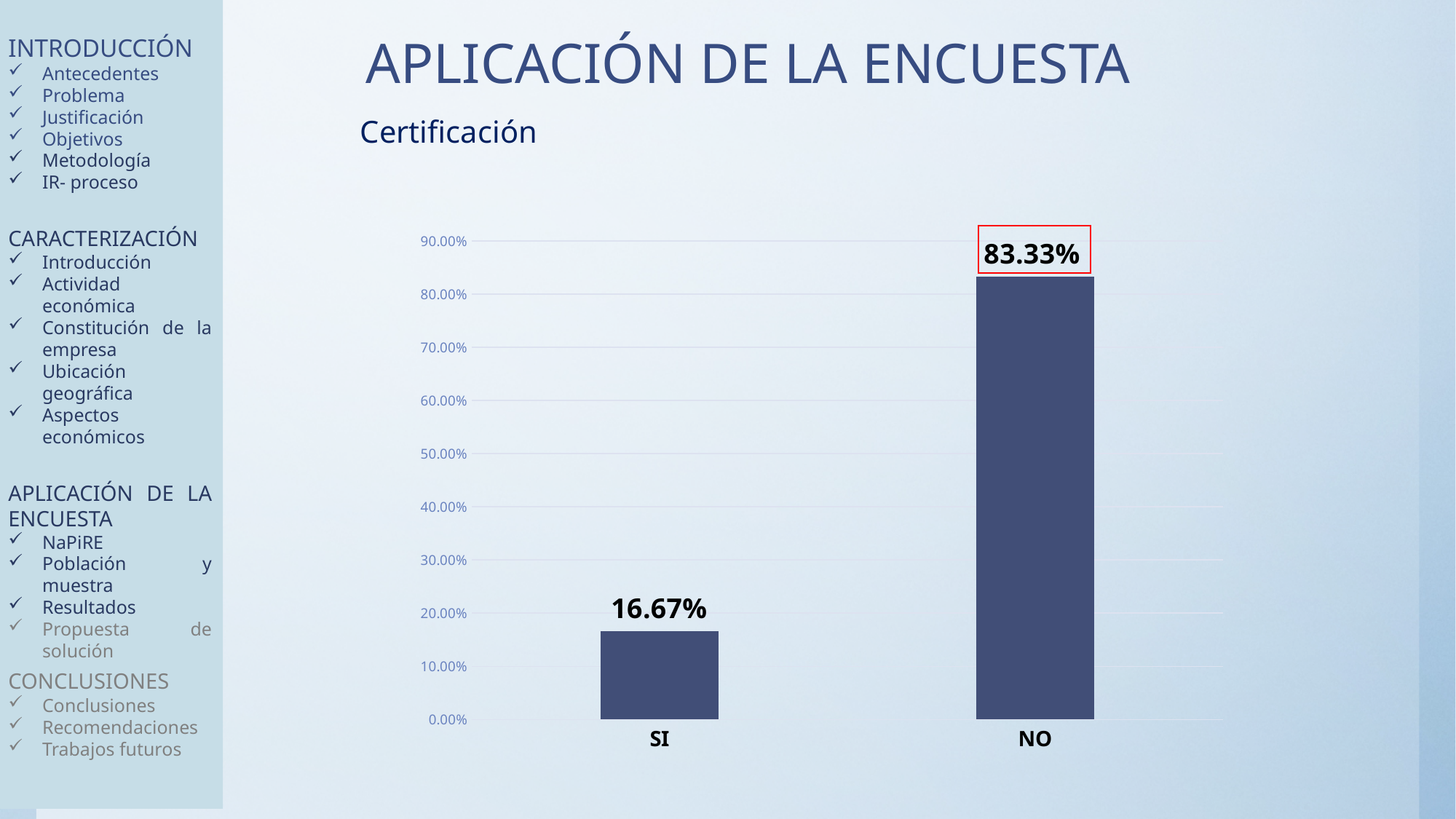
Which category has the highest value? NO What is the difference between the values for NO and SI? 66.66% What is the value for SI? 16.67% What is the value for NO? 83.33% How many categories are shown on the x axis? 2 Which is larger, the value for SI or the value for NO? NO What is the title shown above the chart? Certificación What kind of chart is shown on the slide? bar chart Which category has the lowest value? SI What is the highest value shown on the y axis? 90.00% Is the value for SI greater or less than 20.00%? less Is the value for NO greater or less than 80.00%? greater